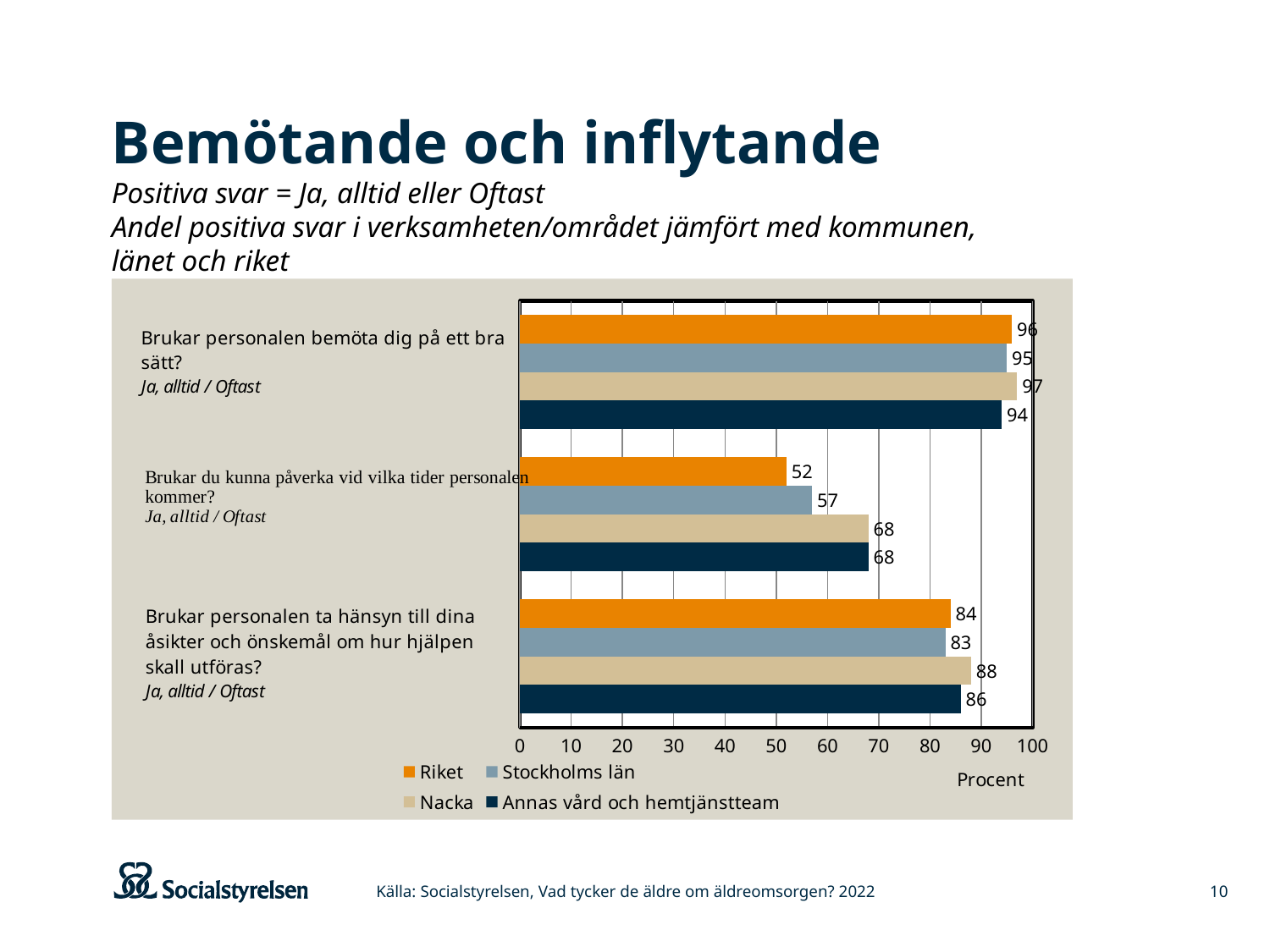
What label is shown on the horizontal axis of the chart? Procent How many question categories are plotted on the chart? 3 How many series does the legend list? 4 Which series has the highest value on the question "Brukar personalen ta hänsyn till dina åsikter och önskemål om hur hjälpen skall utföras?"? Nacka What is the value for Annas vård och hemtjänstteam on the question "Brukar personalen bemöta dig på ett bra sätt?"? 94 Which series has the lowest value on the question "Brukar du kunna påverka vid vilka tider personalen kommer?"? Riket Which is larger on the question "Brukar personalen ta hänsyn till dina åsikter och önskemål om hur hjälpen skall utföras?": Annas vård och hemtjänstteam or Stockholms län? Annas vård och hemtjänstteam What is the value for Nacka on the question "Brukar personalen ta hänsyn till dina åsikter och önskemål om hur hjälpen skall utföras?"? 88 What is the value for Riket on the question "Brukar du kunna påverka vid vilka tider personalen kommer?"? 52 What kind of chart is shown on the slide? Bar chart What is the difference between Nacka and Riket on the question "Brukar du kunna påverka vid vilka tider personalen kommer?"? 16 Is the value for Stockholms län on the question "Brukar du kunna påverka vid vilka tider personalen kommer?" greater or less than 60? less